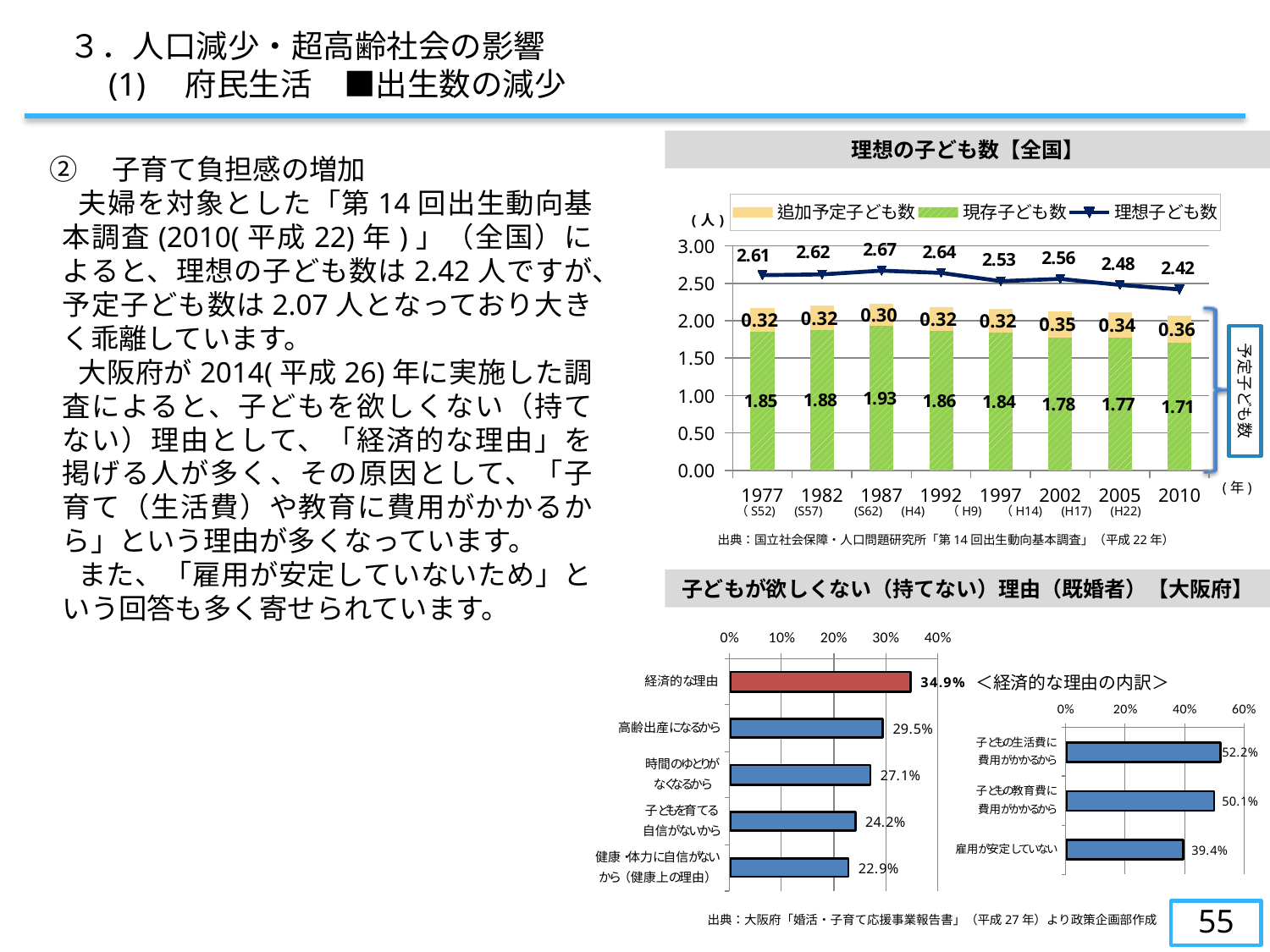
In the chart titled 理想の子ども数【全国】, what is the value of 現存子ども数 for 1987? 1.93 In the chart titled 子どもが欲しくない（持てない）理由（既婚者）【大阪府】, what is the value for 経済的な理由? 34.9% In the chart titled 理想の子ども数【全国】, which year has the lowest 現存子ども数? 2010 In the chart titled 理想の子ども数【全国】, what is the difference between 理想子ども数 in 1977 and in 2010? 0.19 In the chart titled 理想の子ども数【全国】, how many series does the legend list? 3 In the chart titled 子どもが欲しくない（持てない）理由（既婚者）【大阪府】, how many reasons are plotted? 5 In the chart titled 理想の子ども数【全国】, does 理想子ども数 generally rise or fall from 1987 to 2010? fall In the chart titled 子どもが欲しくない（持てない）理由（既婚者）【大阪府】, which reason has the lowest value? 健康・体力に自信がないから（健康上の理由） In the chart titled 理想の子ども数【全国】, which year has the highest 理想子ども数? 1987 In the chart titled 理想の子ども数【全国】, what is the total of the stacked bar (現存子ども数 plus 追加予定子ども数) for 2010? 2.07 In the chart titled 理想の子ども数【全国】, what is the value of 理想子ども数 for 2010? 2.42 In the inset chart titled ＜経済的な理由の内訳＞, which is larger: 子どもの生活費に費用がかかるから or 雇用が安定していない? 子どもの生活費に費用がかかるから